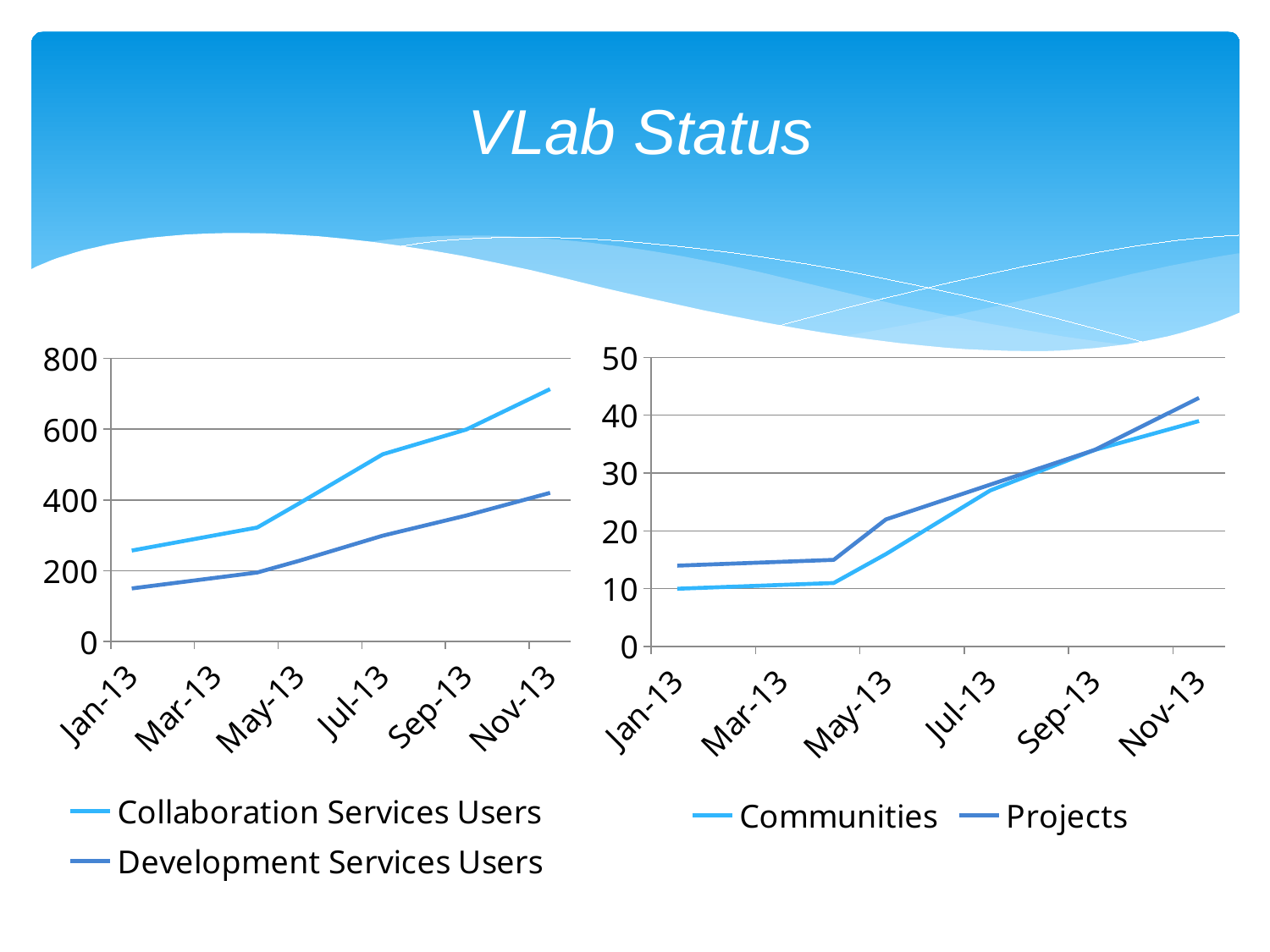
In the right chart, do the values for Communities rise or fall from Jan-13 to Nov-13? rise In the right chart, is the value for Projects at Nov-13 greater or less than 40? greater How many series does the legend of the left chart list? 2 How many series does the legend of the right chart list? 2 In the right chart, which series has the larger value at Jan-13, Communities or Projects? Projects In the left chart, which series has the larger value at Nov-13, Collaboration Services Users or Development Services Users? Collaboration Services Users What kind of chart is the left chart on the slide? line chart In the left chart, is the value for Development Services Users at Jan-13 greater or less than 200? less In the left chart, is the value for Collaboration Services Users at Nov-13 greater or less than 600? greater What is the title of the slide containing the two charts? VLab Status